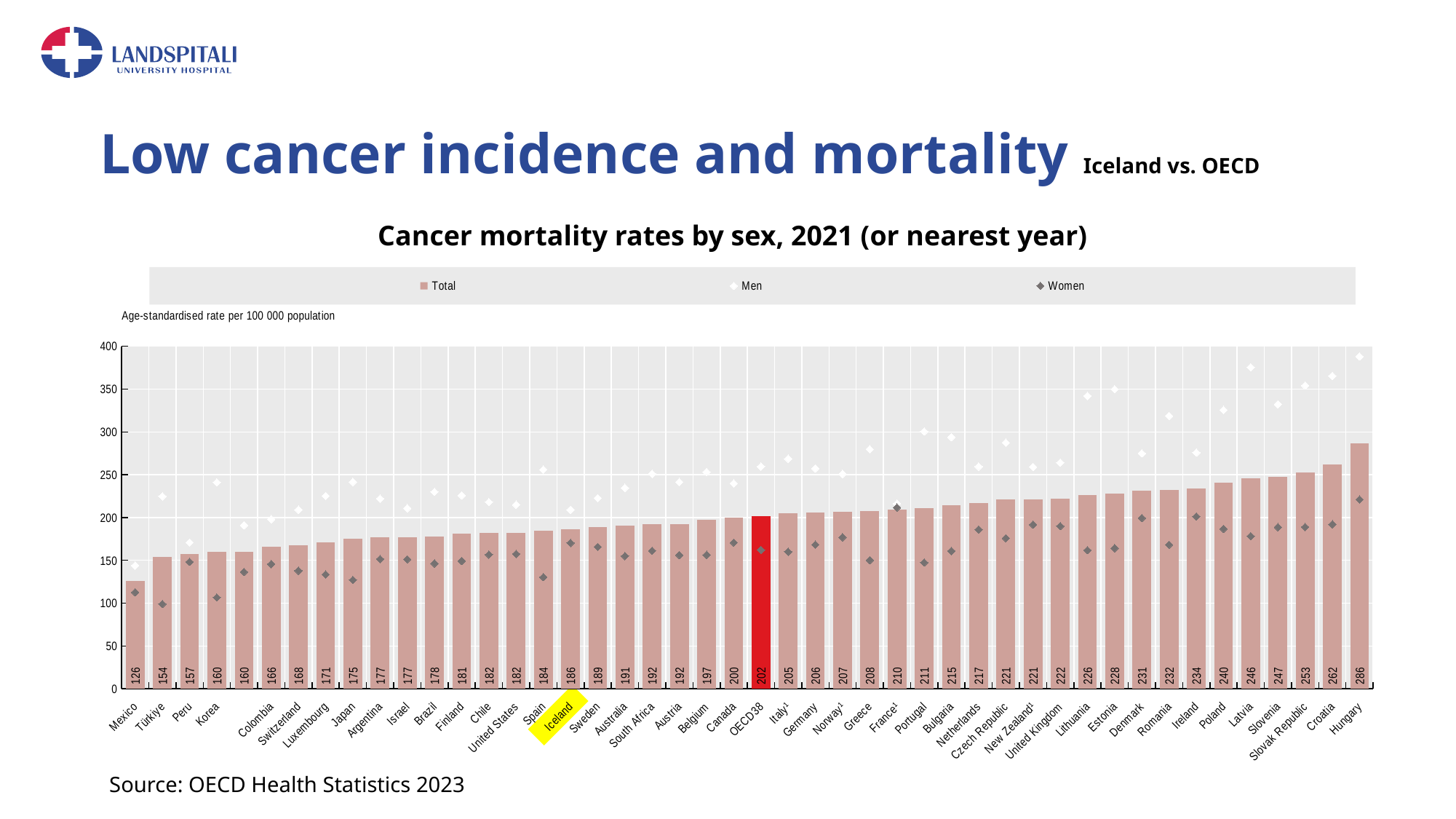
What is the difference between the Total rates for OECD38 and Iceland? 16 What is the difference between the Total rates for Hungary and Mexico? 160 What is the Total cancer mortality rate for OECD38? 202 How many series does the legend list? 3 Do the Total values rise or fall from left to right along the x axis? rise What is the Total cancer mortality rate for Hungary? 286 Which has a higher Total cancer mortality rate, Iceland or OECD38? OECD38 Is the Men value for Hungary greater or less than 350? greater Which country has the highest Total cancer mortality rate? Hungary What is the Total cancer mortality rate for Iceland? 186 What kind of chart is shown on the slide? bar chart Which country has the lowest Total cancer mortality rate? Mexico